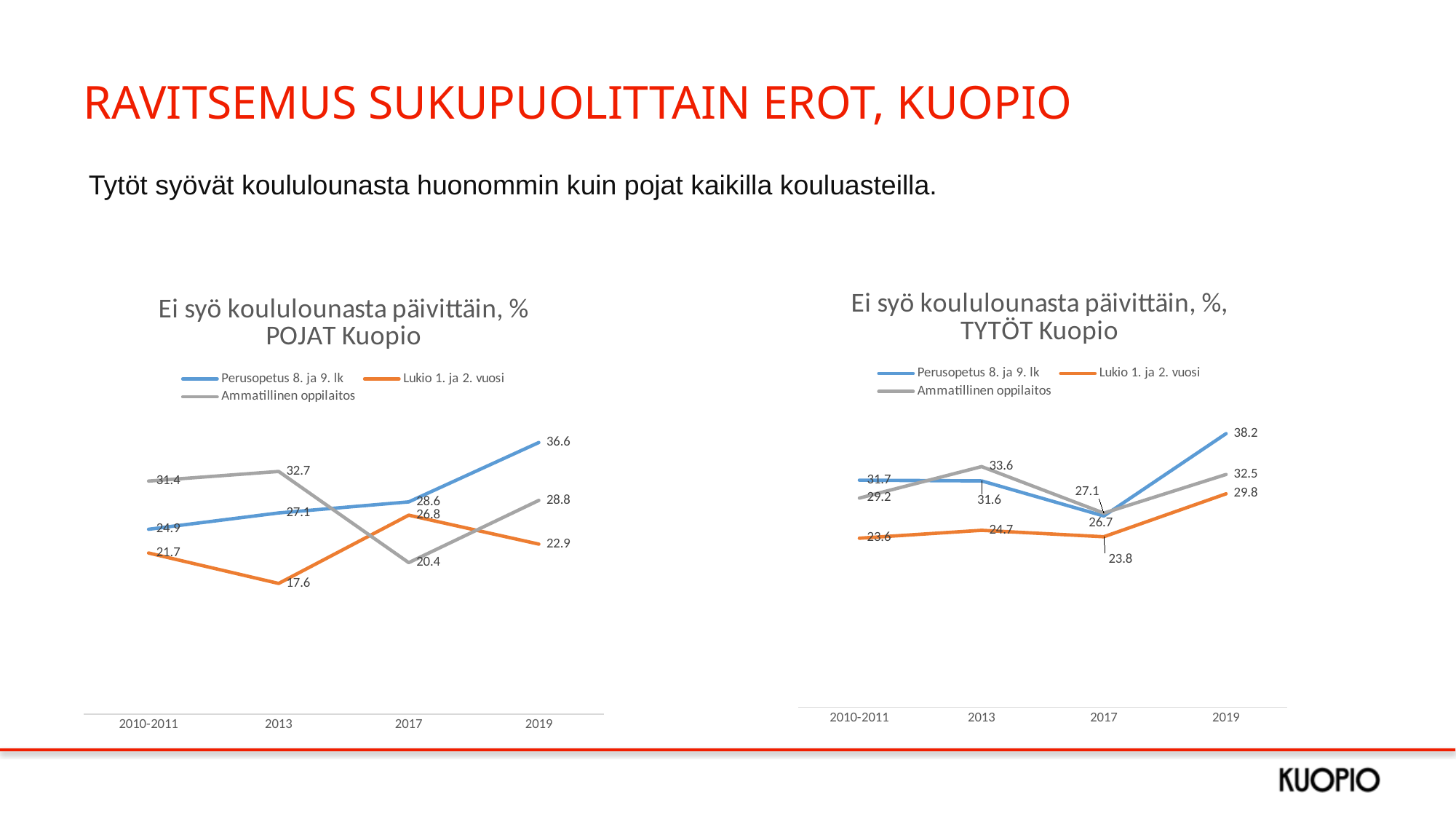
In the TYTÖT Kuopio chart, what is the value for Ammatillinen oppilaitos in 2013? 33.6 How many time points are shown on the x axis of the POJAT Kuopio chart? 4 What kind of chart is the TYTÖT Kuopio chart? Line chart In the POJAT Kuopio chart, what is the value for Lukio 1. ja 2. vuosi in 2013? 17.6 In the TYTÖT Kuopio chart, which series has the highest value in 2019? Perusopetus 8. ja 9. lk In the POJAT Kuopio chart, what is the difference between the Perusopetus 8. ja 9. lk values in 2019 and 2010-2011? 11.7 In the POJAT Kuopio chart, what is the value for Perusopetus 8. ja 9. lk in 2019? 36.6 In the TYTÖT Kuopio chart, what is the value for Lukio 1. ja 2. vuosi in 2019? 29.8 In the POJAT Kuopio chart, which is larger in 2017: Lukio 1. ja 2. vuosi or Ammatillinen oppilaitos? Lukio 1. ja 2. vuosi In the TYTÖT Kuopio chart, what is the difference between Perusopetus 8. ja 9. lk and Lukio 1. ja 2. vuosi in 2019? 8.4 How many series does the legend of the TYTÖT Kuopio chart list? 3 In the POJAT Kuopio chart, which year has the lowest value for Ammatillinen oppilaitos? 2017